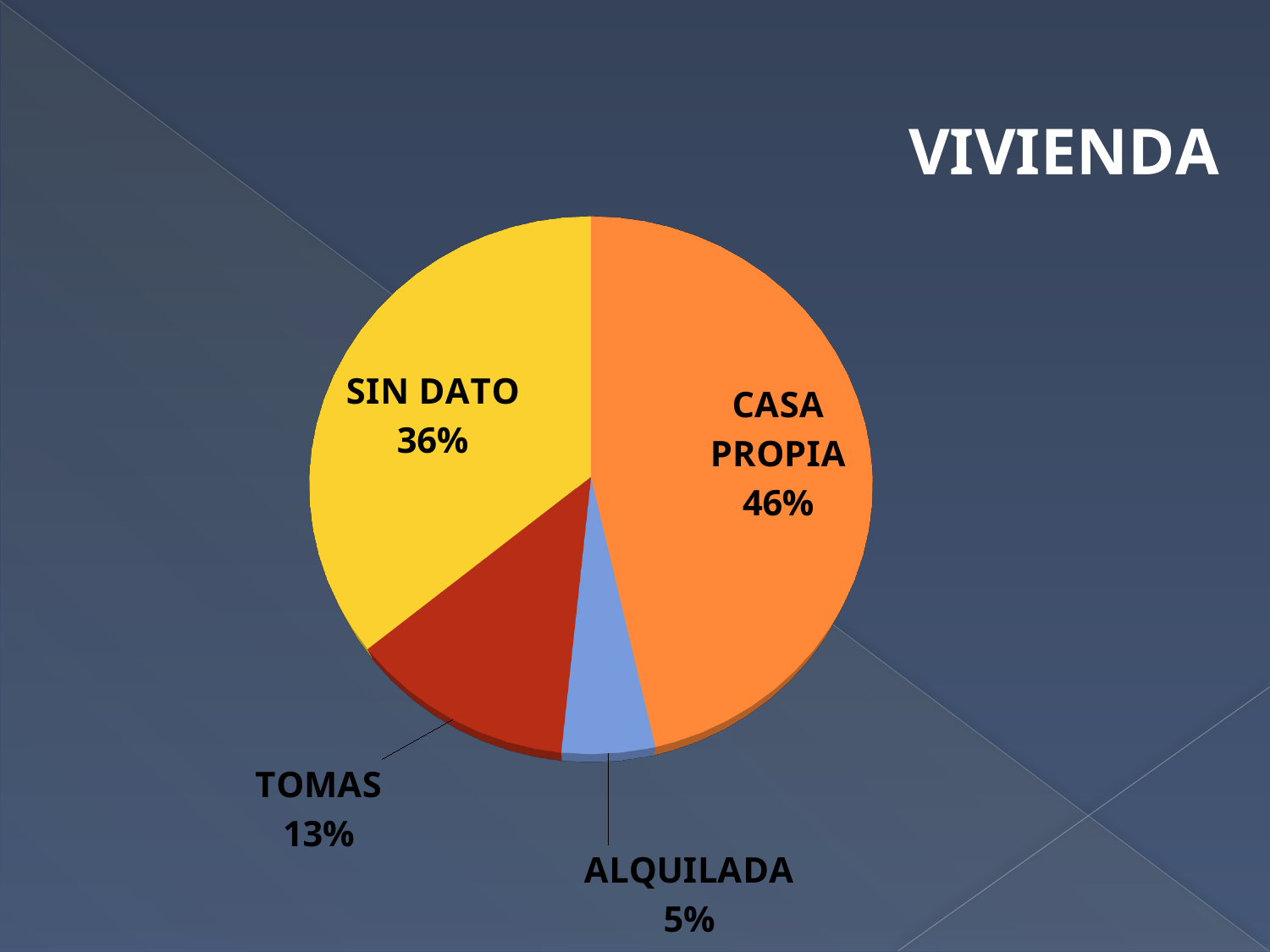
What colour is the SIN DATO slice? yellow What is the difference in percentage points between CASA PROPIA and SIN DATO? 10 What percentage is shown for SIN DATO? 36% What type of chart is shown on the slide? pie chart Which category has the largest share of the pie? CASA PROPIA What percentage is shown for CASA PROPIA? 46% What is the title of the chart? VIVIENDA Which is larger, the share for TOMAS or the share for ALQUILADA? TOMAS How many categories are shown in the pie chart? 4 What percentage is shown for TOMAS? 13% What percentage is shown for ALQUILADA? 5% Which category has the smallest share of the pie? ALQUILADA